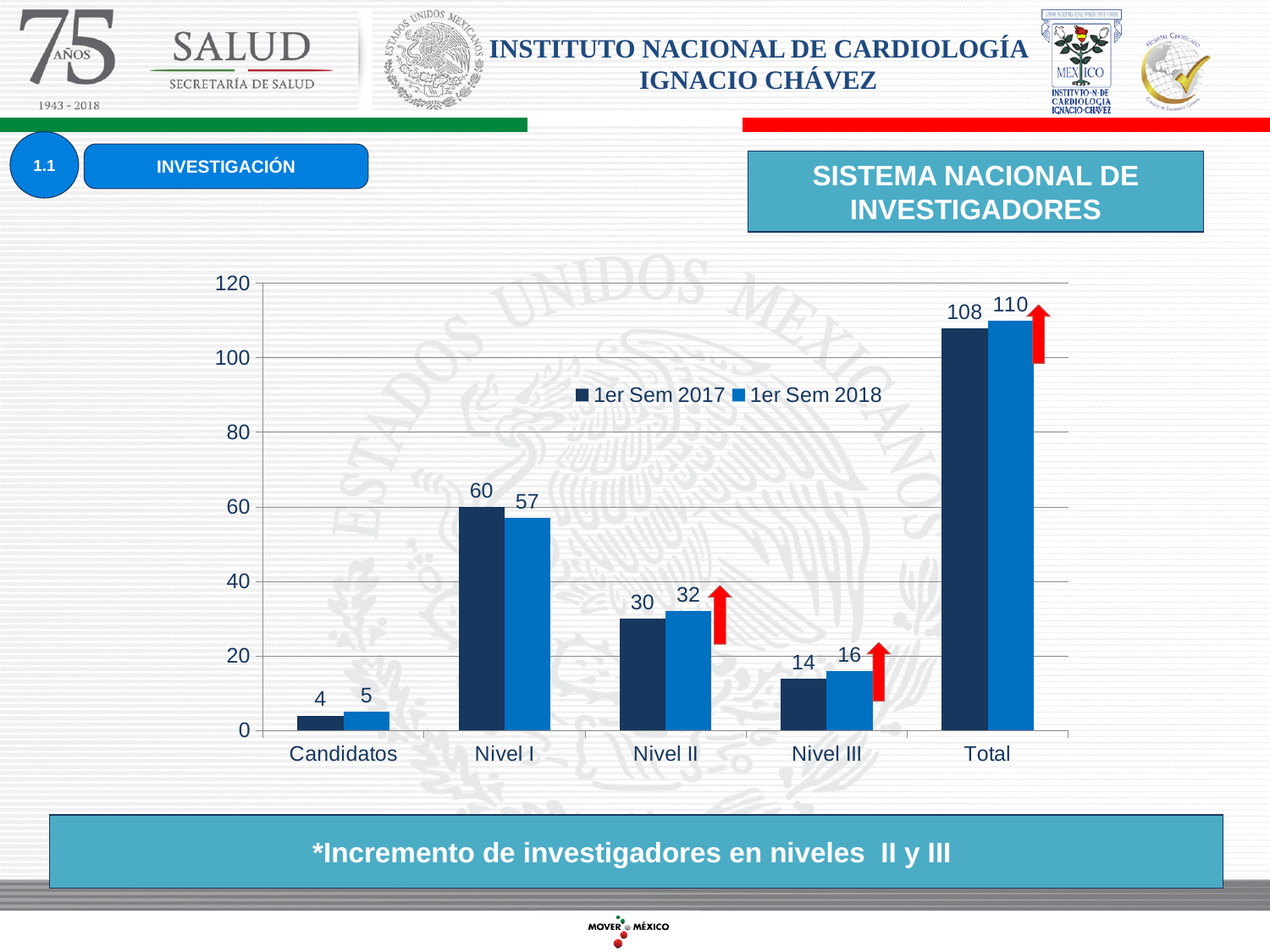
Is the 1er Sem 2017 value for Total greater or less than 100? greater Which is larger for Nivel III: the 1er Sem 2017 value or the 1er Sem 2018 value? 1er Sem 2018 Which category has the highest value in the 1er Sem 2018 series? Total What is the difference between the 1er Sem 2017 and 1er Sem 2018 values for Nivel I? 3 What is the value for Nivel I in the 1er Sem 2017 series? 60 How many series does the legend list? 2 What kind of chart is shown on the slide? Bar chart What is the value for Candidatos in the 1er Sem 2018 series? 5 What is the difference between the 1er Sem 2018 and 1er Sem 2017 values for Nivel II? 2 What is the value for Nivel III in the 1er Sem 2018 series? 16 Which category has the lowest value in the 1er Sem 2017 series? Candidatos How many categories are shown on the x axis? 5